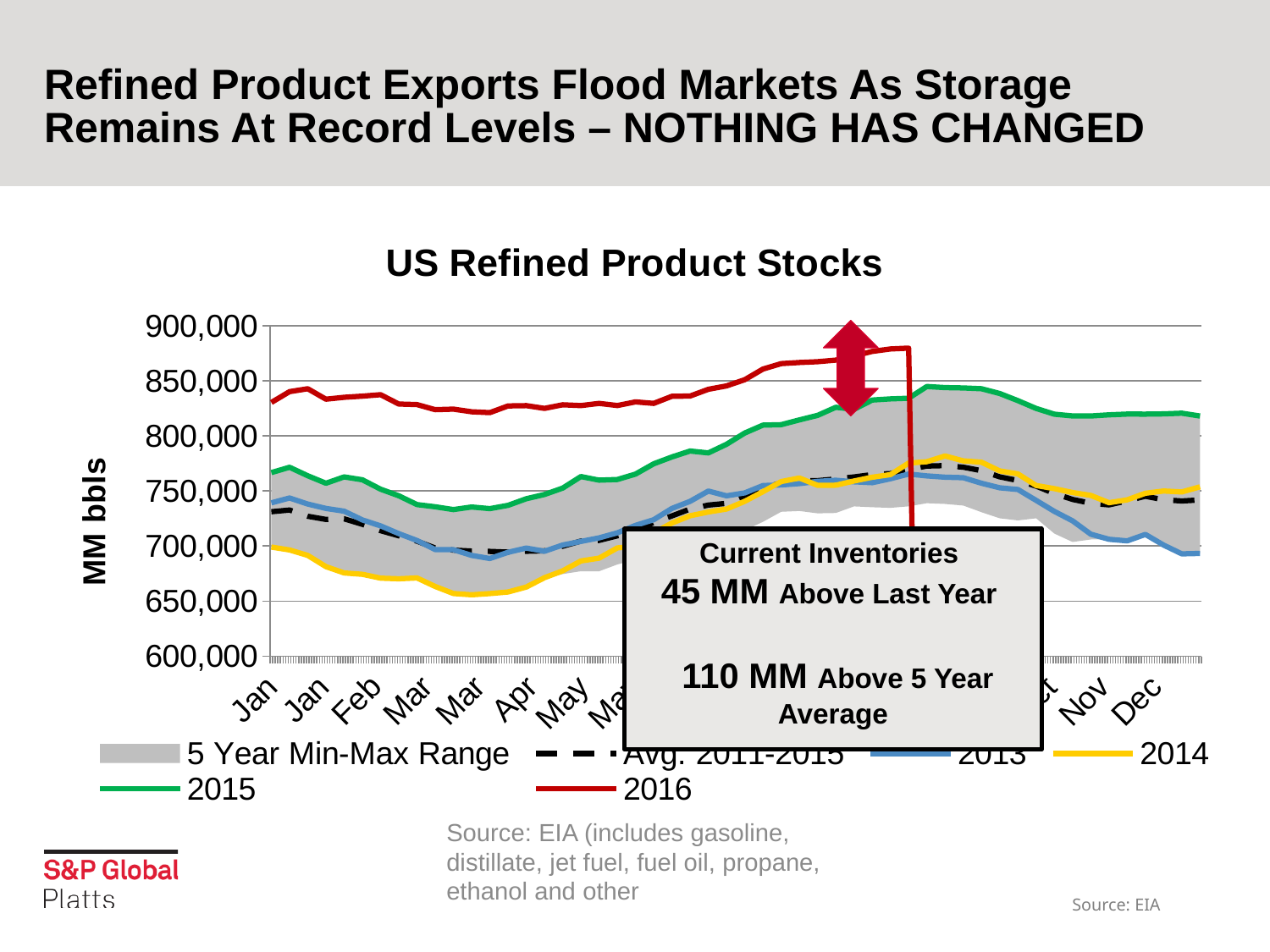
What is the title of the chart? US Refined Product Stocks What kind of chart is shown on the slide? line chart Does the 2016 line generally rise or fall from January to its last plotted point? rise Which series has the highest values across the months shown: 2016 or 2015? 2016 What is the label on the vertical axis of the chart? MM bbls How many entries does the chart legend list? 6 Which year's line is the highest on the chart? 2016 Is the value of the 2015 line in December greater or less than 800,000? greater Is the value of the 2014 line in March greater or less than 700,000? less Is the value of the 2016 line in January greater or less than 800,000? greater In March, which line is higher: 2013 or 2014? 2013